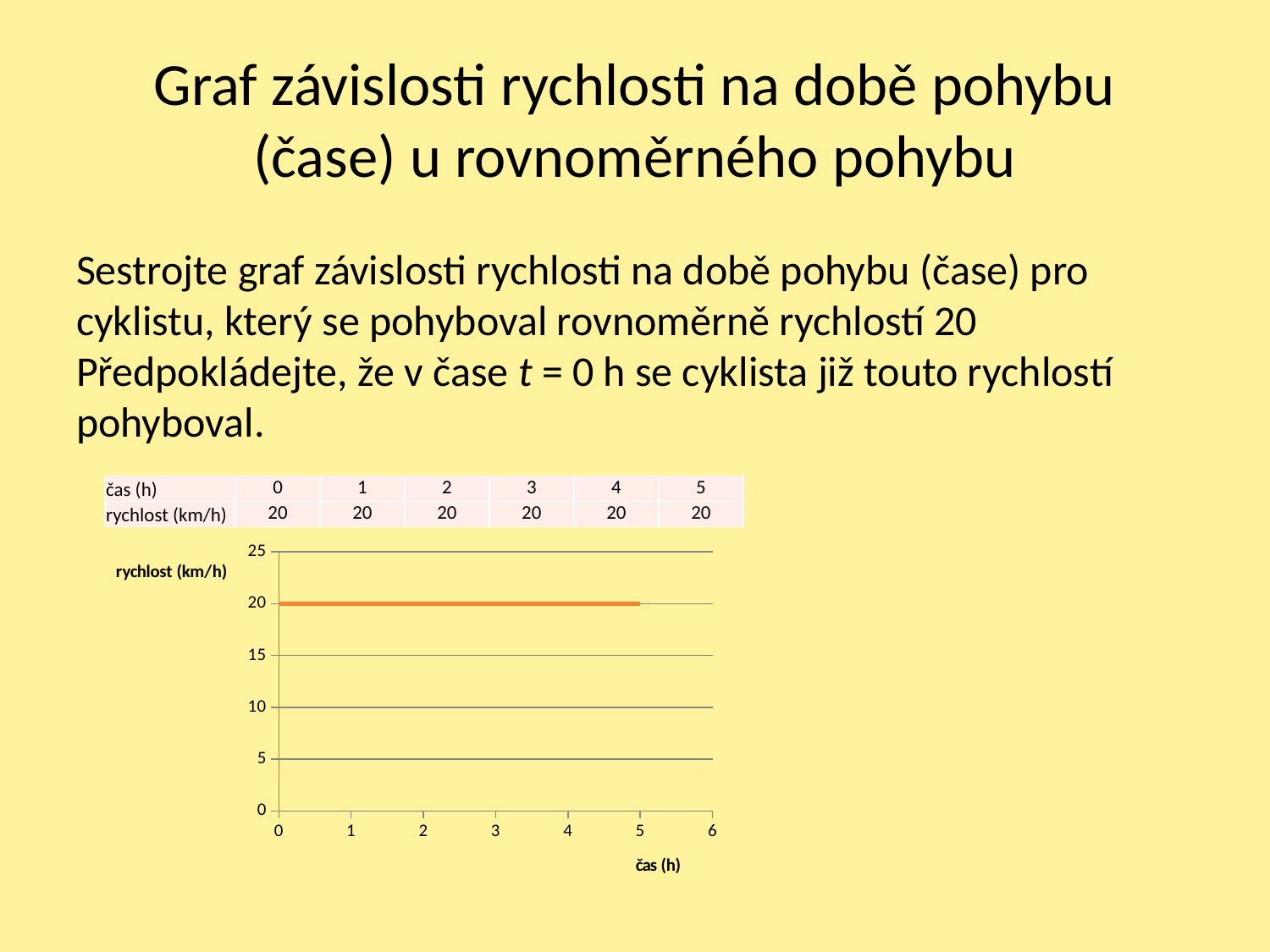
At which value of čas (h) does the plotted line end? 5 How many time points are listed in the data table above the chart? 6 Does the plotted speed rise, fall, or stay constant as čas (h) increases from 0 to 5? stays constant What is the difference between the speed at čas = 1 h and at čas = 4 h? 0 Is the plotted value of rychlost (km/h) greater or less than 25? less Is the plotted value of rychlost (km/h) greater or less than 15? greater What is the value of rychlost (km/h) at čas = 2 h? 20 What is the highest value of rychlost (km/h) shown in the chart? 20 What kind of chart is shown on the slide? line chart What is the label of the horizontal axis of the chart? čas (h) What is the value of rychlost (km/h) at čas = 5 h? 20 What is the label of the vertical axis of the chart? rychlost (km/h)